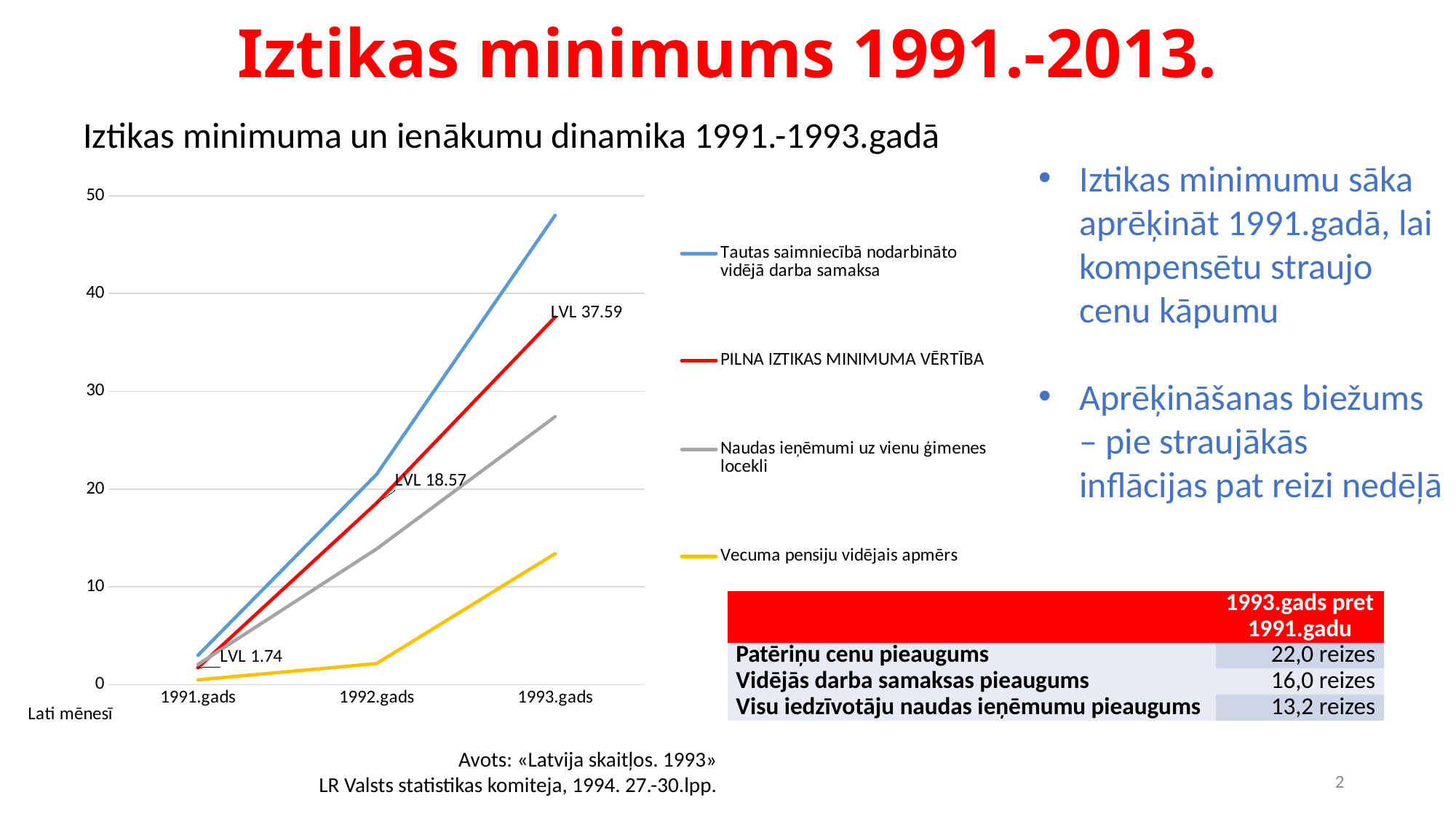
Do the values of PILNA IZTIKAS MINIMUMA VĒRTĪBA rise or fall from 1991.gads to 1993.gads? rise How many years are plotted along the x axis of the chart? 3 What is the value of PILNA IZTIKAS MINIMUMA VĒRTĪBA in 1992.gads? LVL 18.57 Is the value for Tautas saimniecībā nodarbināto vidējā darba samaksa in 1993.gads greater or less than 40? greater How many series does the chart legend list? 4 By how much did PILNA IZTIKAS MINIMUMA VĒRTĪBA increase from 1992.gads to 1993.gads? LVL 19.02 What is the value of PILNA IZTIKAS MINIMUMA VĒRTĪBA in 1993.gads? LVL 37.59 What is the title of the chart? Iztikas minimuma un ienākumu dinamika 1991.-1993.gadā What type of chart is shown on the slide? line chart What is the value of PILNA IZTIKAS MINIMUMA VĒRTĪBA in 1991.gads? LVL 1.74 Which series has the highest value in 1993.gads? Tautas saimniecībā nodarbināto vidējā darba samaksa Which series has the lowest value in 1993.gads? Vecuma pensiju vidējais apmērs